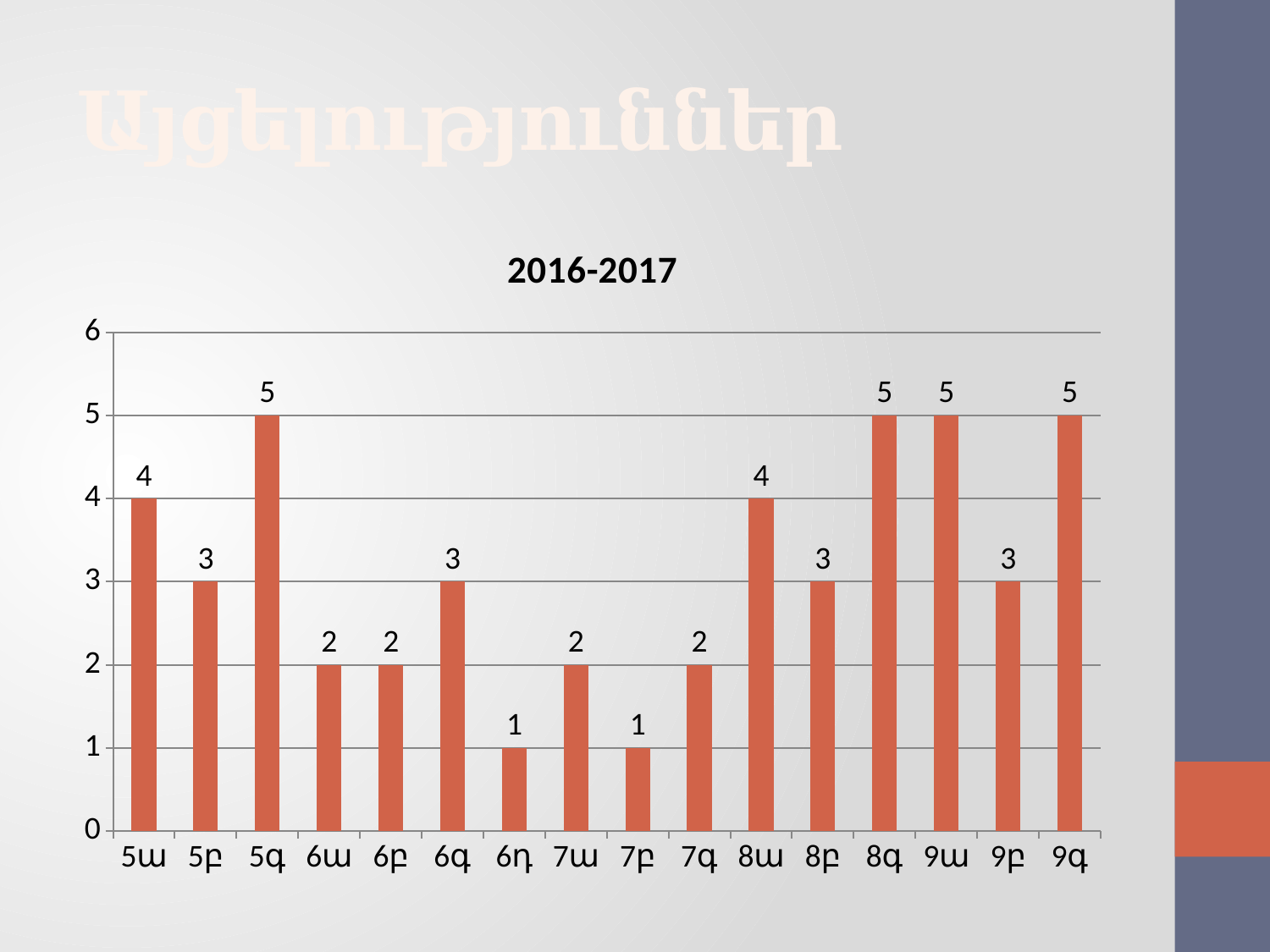
Which is larger, the value for 8ա or the value for 8բ? 8ա What is the value for 5ա? 4 What is the lowest value shown in the chart? 1 What is the title of the chart? 2016-2017 What is the value for 6դ? 1 Is the value for 9ա greater or less than 3? greater What is the value for 8գ? 5 What kind of chart is shown on the slide? bar chart What is the value for 9բ? 3 How many categories are shown on the x axis? 16 What is the difference between the values for 5գ and 6ա? 3 Which categories have the lowest value in the chart? 6դ and 7բ